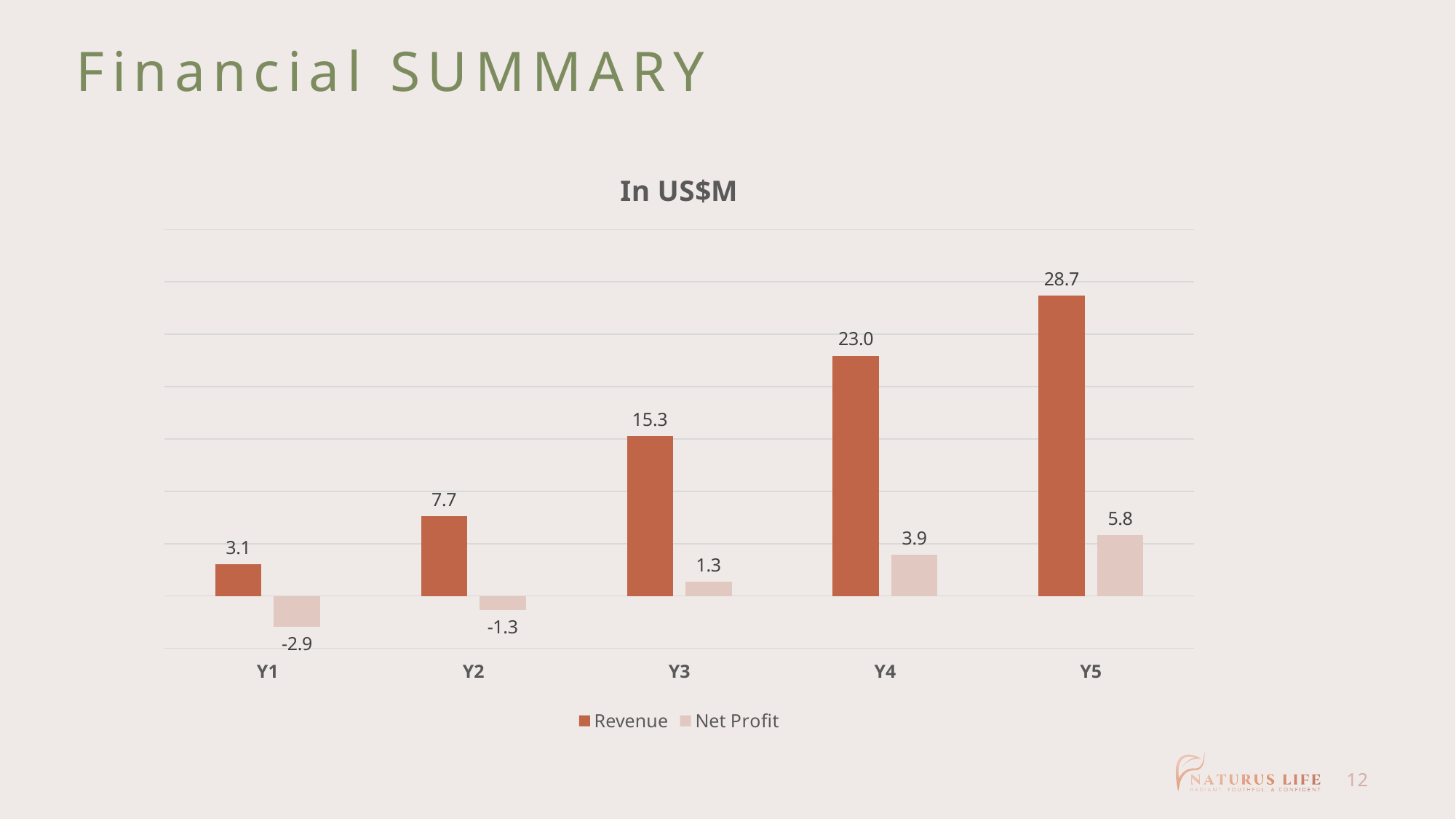
Does Revenue rise or fall from Y1 to Y5? Rise What is the Net Profit value for Y1? -2.9 How many years are shown on the x axis? 5 What is the difference between Revenue in Y5 and Revenue in Y4? 5.7 Which year has the highest Revenue? Y5 What kind of chart is shown on the slide? Bar chart Which year has the lowest Net Profit? Y1 Which is larger, Revenue in Y2 or Net Profit in Y5? Revenue in Y2 How many series does the legend list? 2 What is the Revenue value for Y3? 15.3 What is the Net Profit value for Y5? 5.8 What is the difference between Net Profit in Y4 and Net Profit in Y3? 2.6